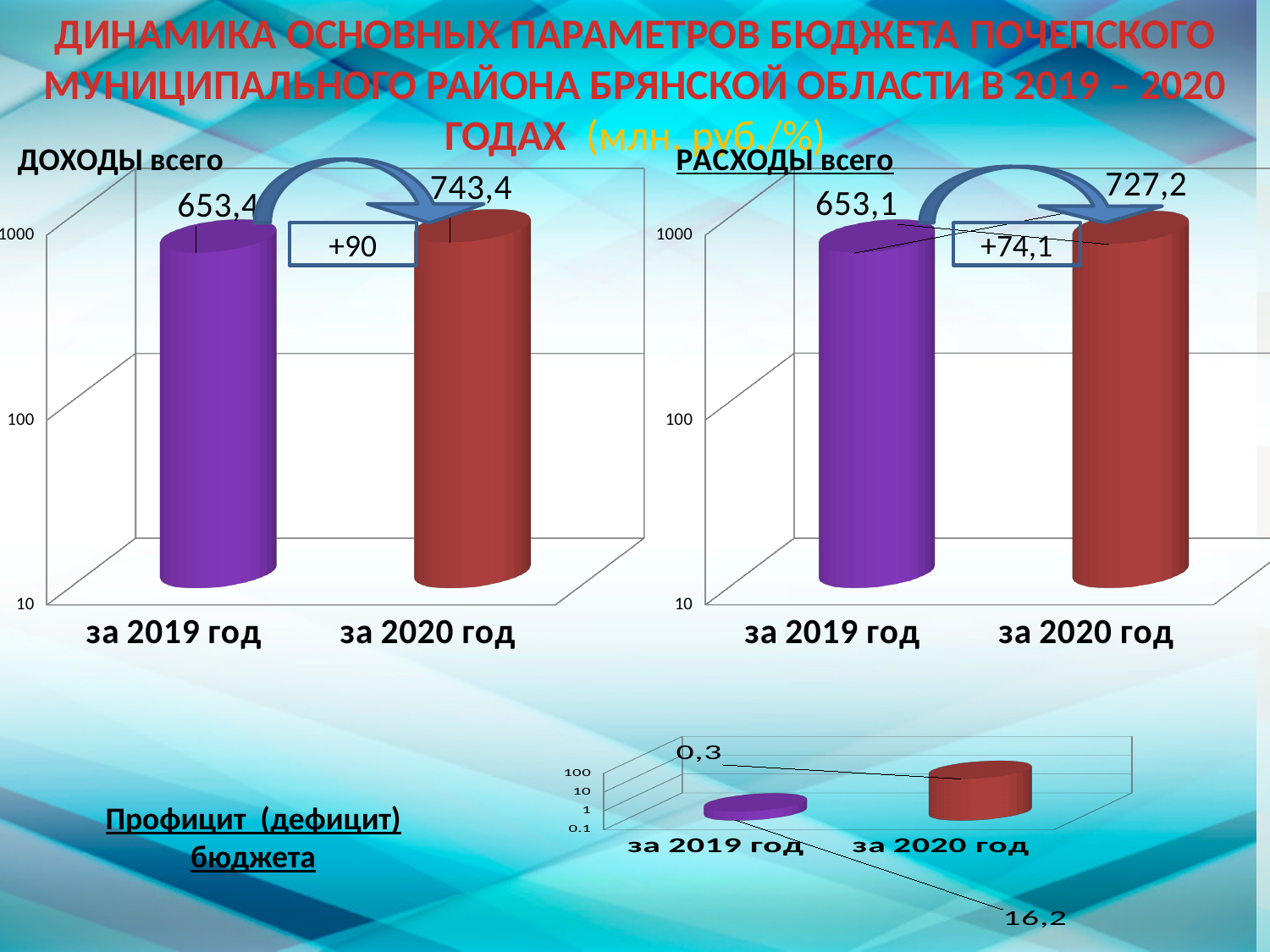
In the chart titled 'РАСХОДЫ всего', what is the value for 'за 2020 год'? 727,2 How many categories are shown in the chart titled 'РАСХОДЫ всего'? 2 In the chart titled 'ДОХОДЫ всего', what is the difference between the 2020 and 2019 values? 90 In the chart titled 'РАСХОДЫ всего', what is the value for 'за 2019 год'? 653,1 In the chart titled 'РАСХОДЫ всего', which year has the lower value? за 2019 год In the chart titled 'ДОХОДЫ всего', what is the value for 'за 2020 год'? 743,4 In the chart titled 'РАСХОДЫ всего', what is the difference between the 2020 and 2019 values? 74,1 In the chart titled 'ДОХОДЫ всего', what is the value for 'за 2019 год'? 653,4 In the chart titled 'ДОХОДЫ всего', do the values rise or fall from 2019 to 2020? rise In the chart titled 'Профицит (дефицит) бюджета' at the bottom of the slide, which year has the larger bar? за 2020 год What kind of chart is the one titled 'ДОХОДЫ всего'? bar chart In the chart titled 'ДОХОДЫ всего', which year has the higher value? за 2020 год